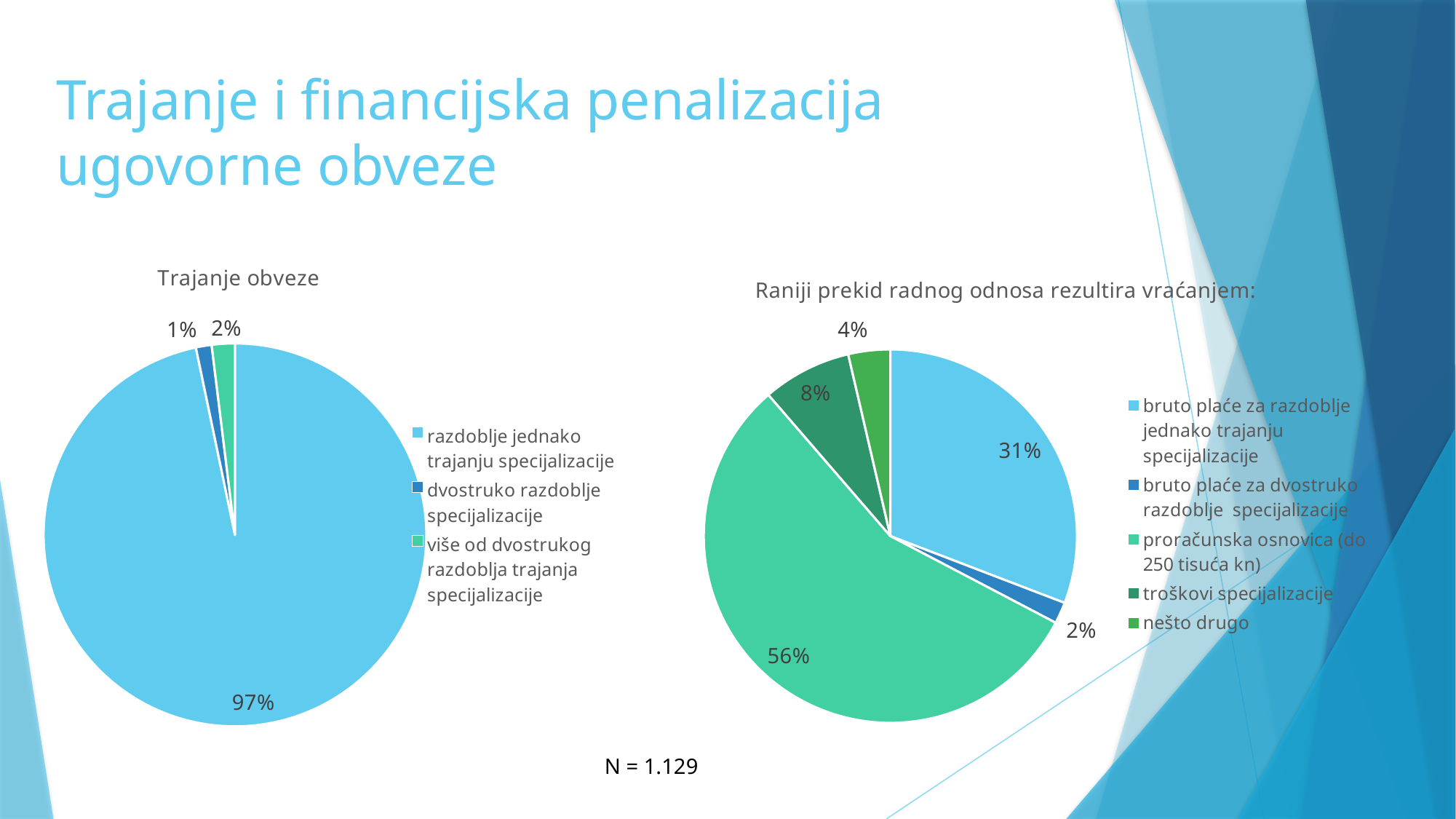
In the 'Trajanje obveze' chart, what share is labelled for 'više od dvostrukog razdoblja trajanja specijalizacije'? 2% In the 'Raniji prekid radnog odnosa rezultira vraćanjem:' chart, which category has the smallest slice? bruto plaće za dvostruko razdoblje specijalizacije In the 'Trajanje obveze' chart, what share is labelled for 'razdoblje jednako trajanju specijalizacije'? 97% In the 'Raniji prekid radnog odnosa rezultira vraćanjem:' chart, which is larger: 'troškovi specijalizacije' or 'nešto drugo'? troškovi specijalizacije In the 'Raniji prekid radnog odnosa rezultira vraćanjem:' chart, what share is labelled for 'troškovi specijalizacije'? 8% How many entries does the legend of the 'Raniji prekid radnog odnosa rezultira vraćanjem:' chart list? 5 In the 'Trajanje obveze' chart, which category has the largest slice? razdoblje jednako trajanju specijalizacije What kind of chart is 'Raniji prekid radnog odnosa rezultira vraćanjem:'? pie chart In the 'Raniji prekid radnog odnosa rezultira vraćanjem:' chart, what is the difference between the shares for 'proračunska osnovica (do 250 tisuća kn)' and 'bruto plaće za razdoblje jednako trajanju specijalizacije'? 25% How many slices does the 'Trajanje obveze' pie chart have? 3